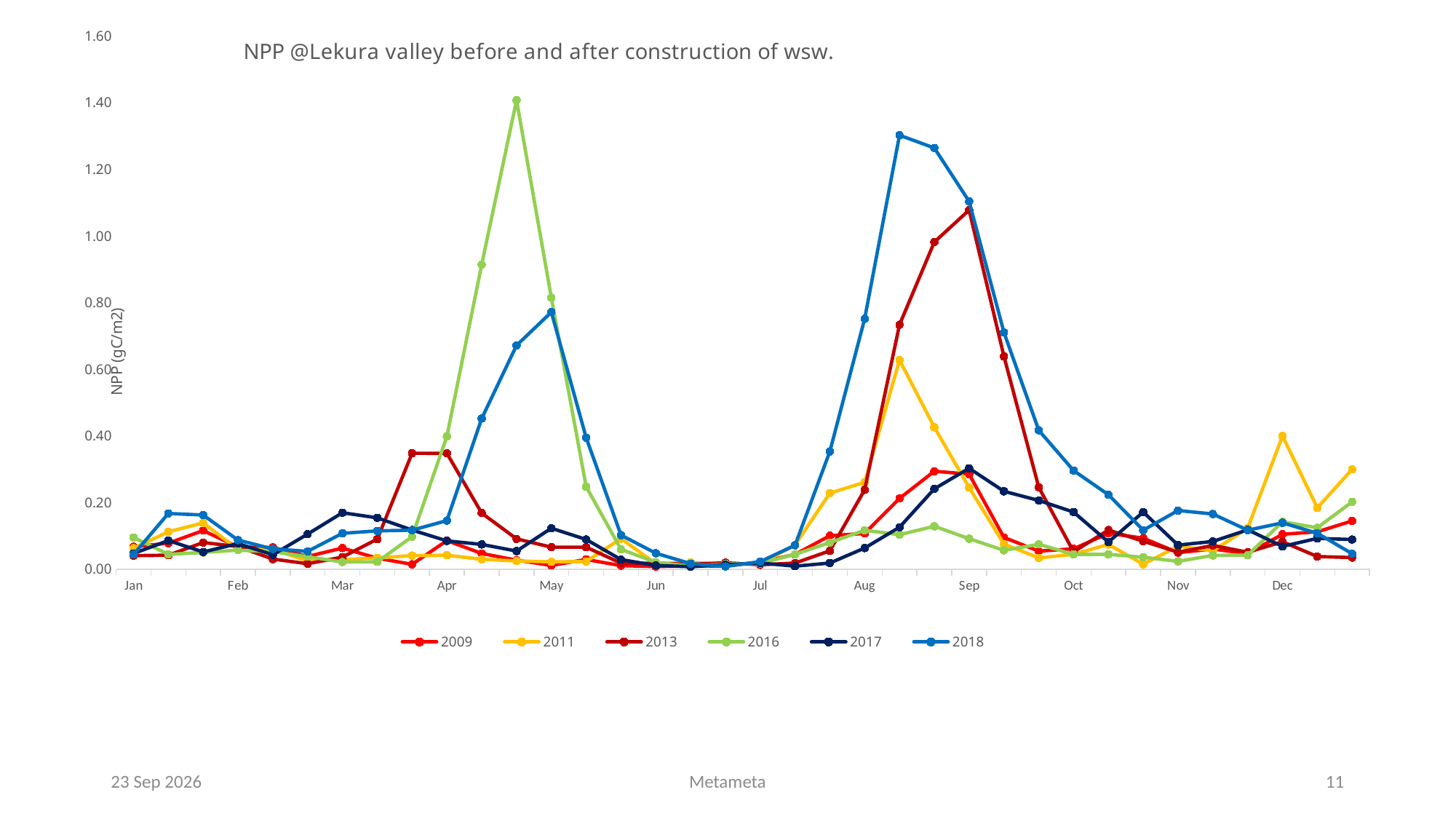
What kind of chart is shown on the slide? line chart Does the 2018 series rise or fall from its August peak through to December? fall What is the title of the chart? NPP @Lekura valley before and after construction of wsw. How many month labels are shown along the x axis? 12 Is the peak value of the 2018 series in August greater or less than 1.20? greater Which series has the larger value at the Aug tick, 2018 or 2016? 2018 What is the label on the vertical axis? NPP (gC/m2) Which series reaches the highest value anywhere on the chart? 2016 How many series does the legend list? 6 Is the highest value of the 2017 series greater or less than 0.40? less Is the peak value of the 2016 series greater or less than 1.20? greater